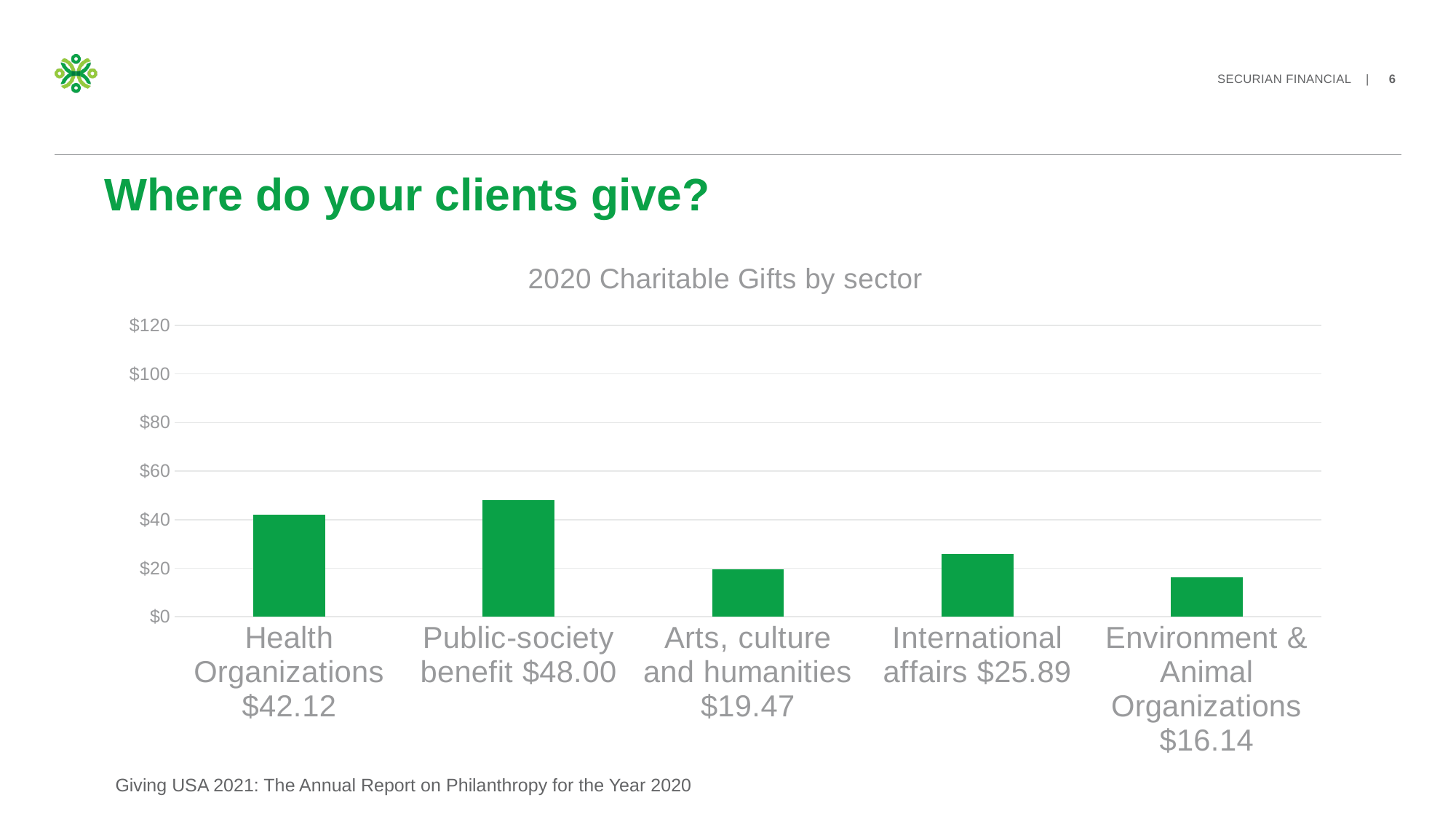
What is the title of the chart? 2020 Charitable Gifts by sector What is the value for Public-society benefit? $48.00 Which sector has the lowest value? Environment & Animal Organizations What is the difference between Public-society benefit and Health Organizations? $5.88 What is the value for Health Organizations in the 2020 Charitable Gifts by sector chart? $42.12 What kind of chart is shown on the slide? Bar chart Which sector has the highest value? Public-society benefit What is the value for International affairs? $25.89 Which is larger, International affairs or Arts, culture and humanities? International affairs What is the value for Environment & Animal Organizations? $16.14 How many sectors are shown in the chart? 5 What is the value for Arts, culture and humanities? $19.47